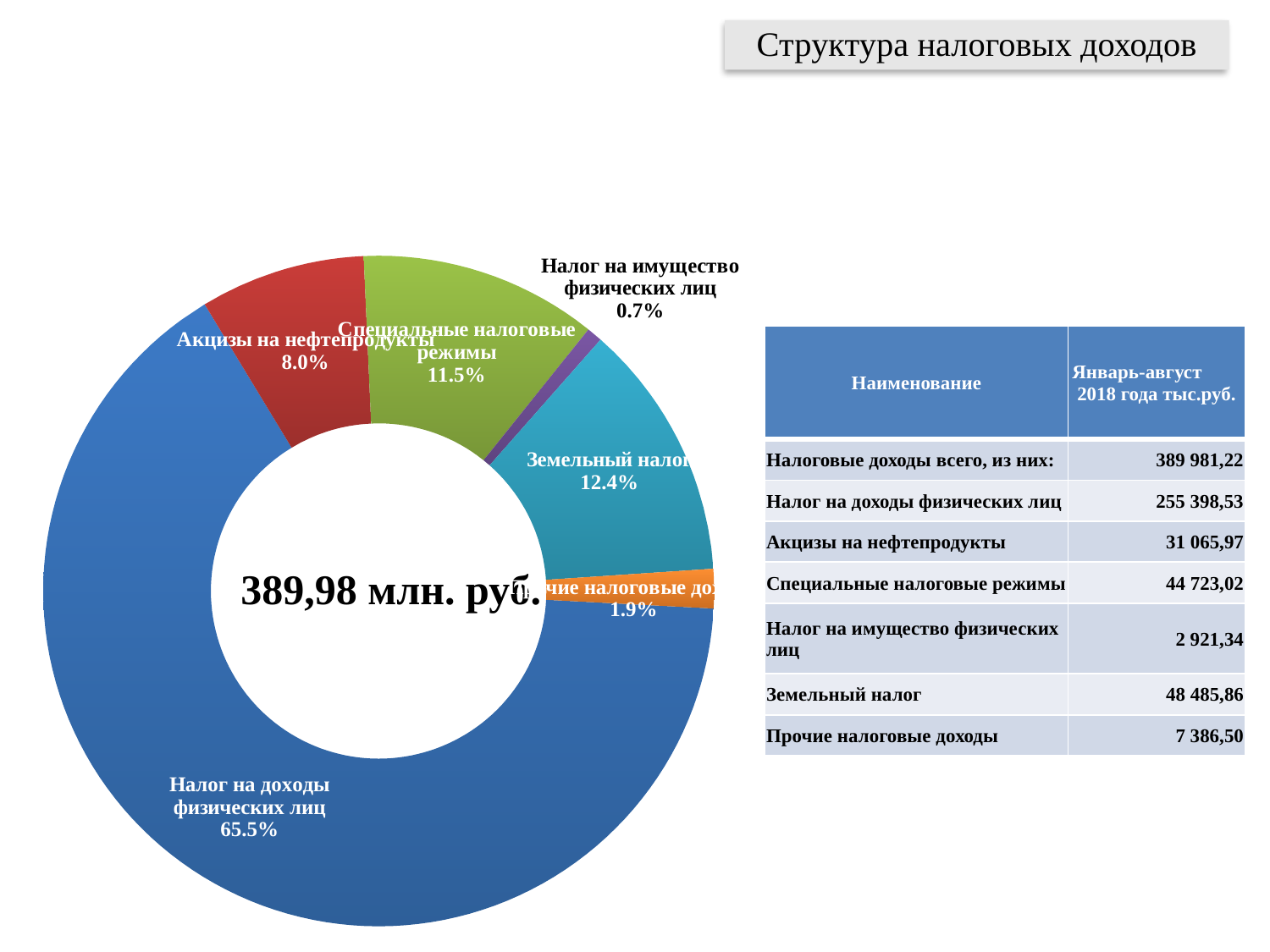
Which is larger: the share of "Земельный налог" or the share of "Специальные налоговые режимы"? Земельный налог What share of the chart does "Земельный налог" have? 12.4% What share of the chart does "Акцизы на нефтепродукты" have? 8.0% Which category has the largest slice in the chart? Налог на доходы физических лиц What share of the chart does "Налог на имущество физических лиц" have? 0.7% What kind of chart is shown on the slide? Doughnut (pie) chart How many slices does the chart have? 6 What total value is printed in the centre of the doughnut chart? 389,98 млн. руб. Which category has the smallest slice in the chart? Налог на имущество физических лиц What is the difference in percentage points between the shares of "Земельный налог" and "Акцизы на нефтепродукты"? 4.4